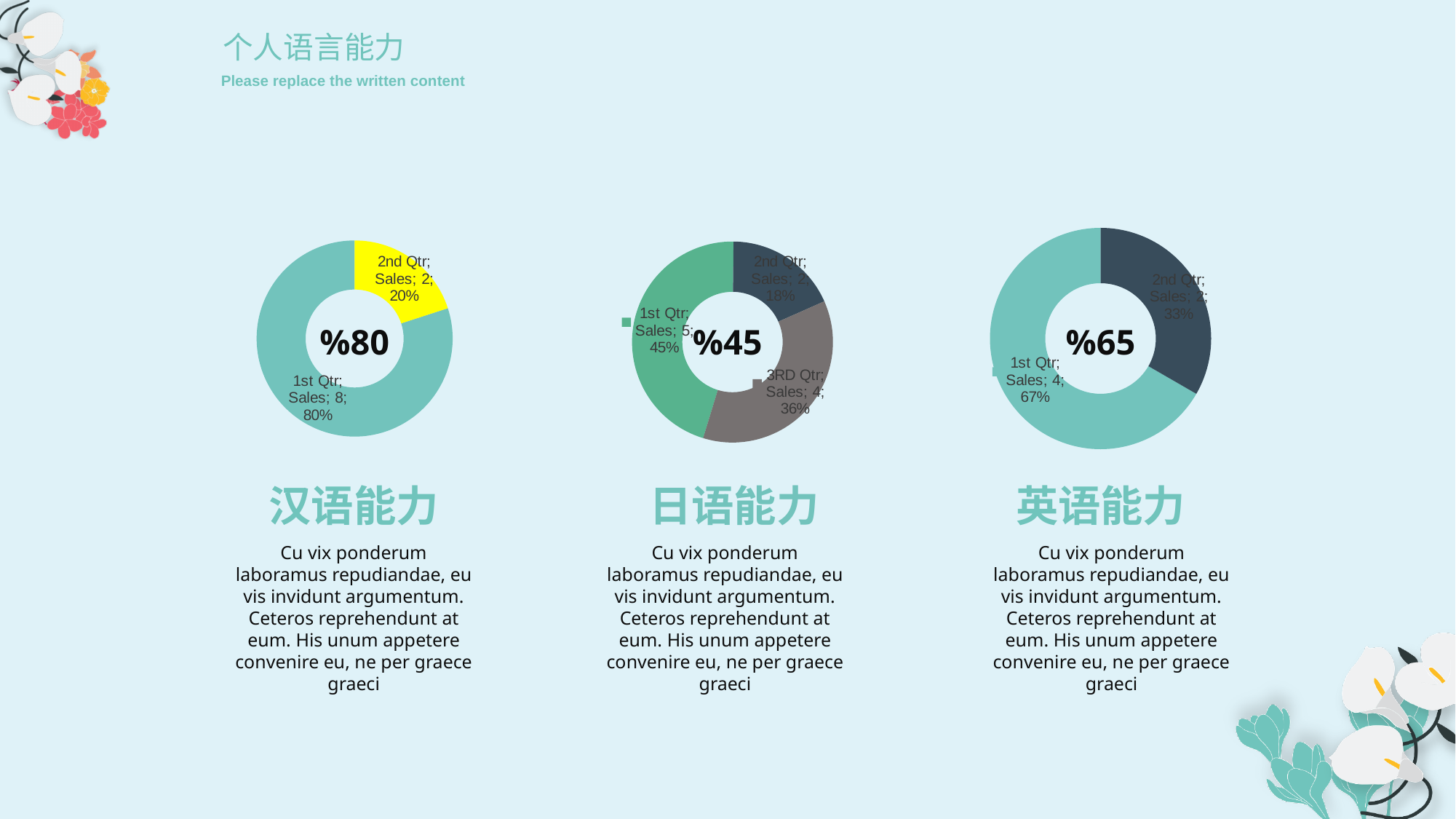
How many slices does the middle chart (above 日语能力) have? 3 In the right chart (above 英语能力), what is the Sales value for 1st Qtr? 4 In the left chart (above 汉语能力), what is the Sales value for 1st Qtr? 8 In the middle chart (above 日语能力), what is the Sales value for 3RD Qtr? 4 In the middle chart (above 日语能力), which quarter has the largest slice? 1st Qtr In the left chart (above 汉语能力), what share of the doughnut does 2nd Qtr take? 20% In the right chart (above 英语能力), which is larger, the 1st Qtr or the 2nd Qtr slice? 1st Qtr What kind of chart is the left chart (above 汉语能力)? doughnut chart In the middle chart (above 日语能力), what share of the doughnut does 2nd Qtr take? 18% In the middle chart (above 日语能力), which quarter has the smallest slice? 2nd Qtr In the left chart (above 汉语能力), what is the difference between the 1st Qtr and 2nd Qtr Sales values? 6 What percentage is printed in the centre of the right chart (above 英语能力)? %65